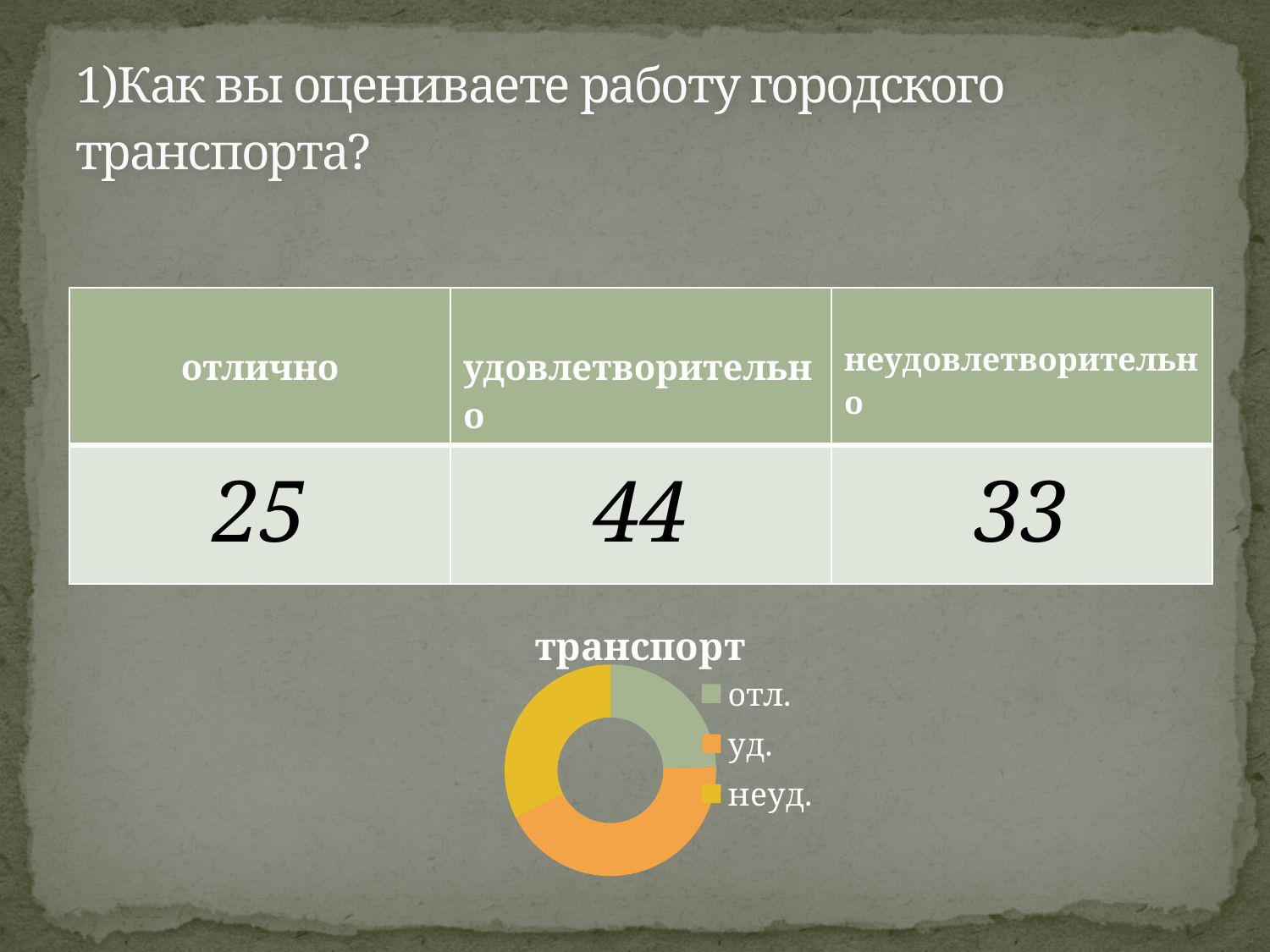
What kind of chart is shown on the slide? doughnut chart Which category has the smallest slice in the chart? отл. What is the title of the chart? транспорт Which category has the largest slice in the chart? уд. Which slice is larger, неуд. or отл.? неуд. According to the table above the chart, what is the value for отлично? 25 How many entries does the chart legend list? 3 Which slice is larger, уд. or отл.? уд. Using the table values, what is the difference between удовлетворительно and отлично? 19 According to the table above the chart, what is the value for удовлетворительно? 44 How many slices does the doughnut chart have? 3 According to the table above the chart, what is the value for неудовлетворительно? 33